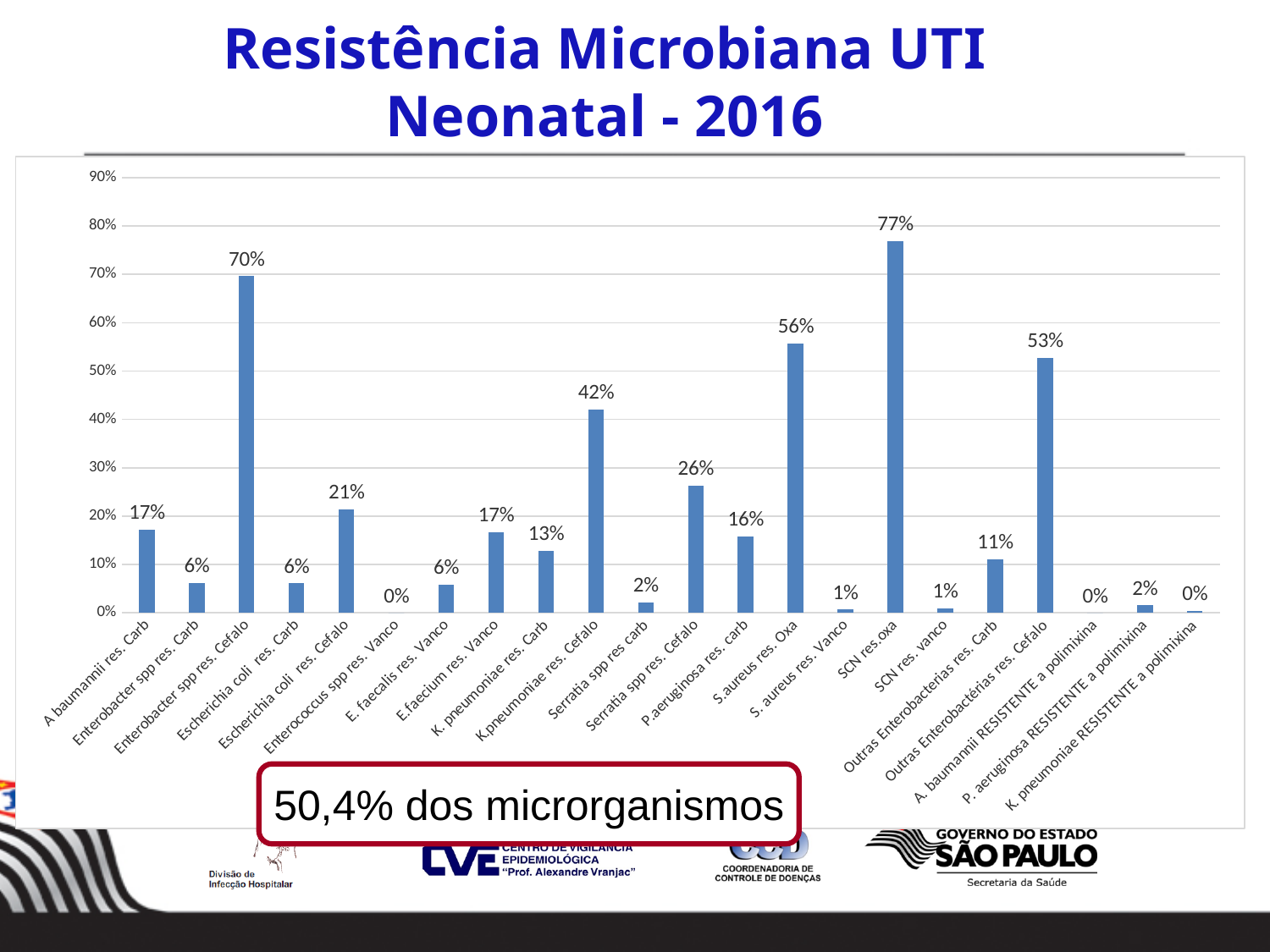
What is the difference between S.aureus res. Oxa and Serratia spp res. Cefalo? 30% What is the value for Outras Enterobactérias res. Cefalo? 53% How many categories are shown on the x axis? 22 What is the value for SCN res.oxa? 77% Is the value for S.aureus res. Oxa greater or less than 50%? greater What is the value for K.pneumoniae res. Cefalo? 42% Which is larger, Escherichia coli res. Cefalo or P.aeruginosa res. carb? Escherichia coli res. Cefalo What kind of chart is shown on the slide? bar chart What is the title of the slide? Resistência Microbiana UTI Neonatal - 2016 What is the difference between SCN res.oxa and Enterobacter spp res. Cefalo? 7% Which category has the highest value? SCN res.oxa What is the value for Enterobacter spp res. Cefalo? 70%